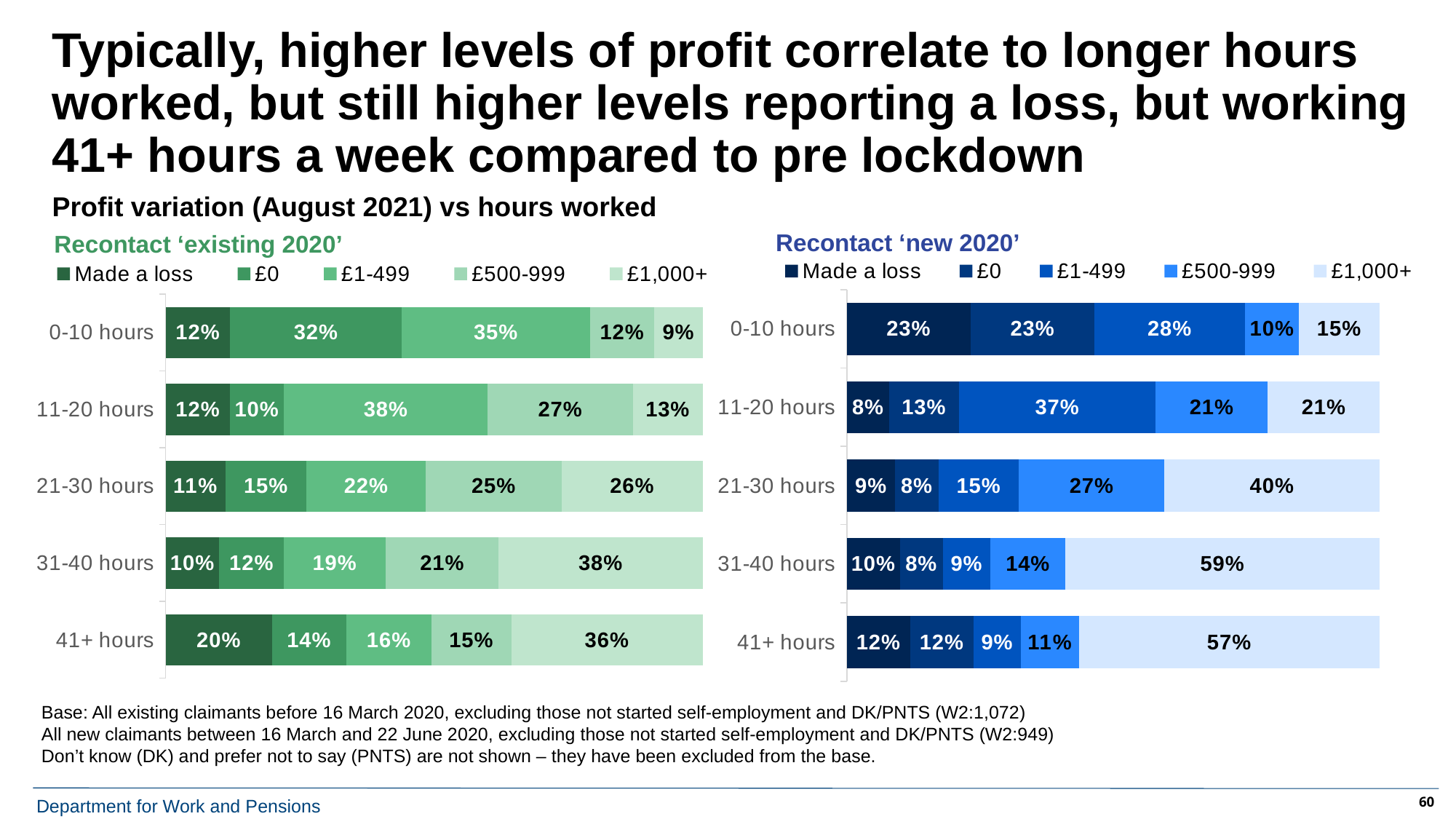
What type of chart is the Recontact 'existing 2020' chart? Stacked bar chart In the Recontact 'new 2020' chart, does the £1,000+ share rise or fall from 0-10 hours to 31-40 hours? Rise What colour are the bars in the Recontact 'new 2020' chart? Blue In the Recontact 'existing 2020' chart, what percentage of those working 0-10 hours reported £0 profit? 32% In the Recontact 'existing 2020' chart, which is larger for 41+ hours: the £1,000+ share or the £1-499 share? £1,000+ (36%) How many hours categories are shown in the Recontact 'existing 2020' chart? 5 How many series does the legend of the Recontact 'new 2020' chart list? 5 In the Recontact 'new 2020' chart, what is the difference between the £1,000+ share for 21-30 hours and for 11-20 hours? 19 percentage points In the Recontact 'existing 2020' chart, which hours category has the highest share reporting 'Made a loss'? 41+ hours In the Recontact 'new 2020' chart, which hours category has the lowest share reporting £1,000+ profit? 0-10 hours In the Recontact 'new 2020' chart, what percentage of those working 31-40 hours reported £1,000+ profit? 59% In the Recontact 'existing 2020' chart, what is the total of the 21-30 hours bar? 99%